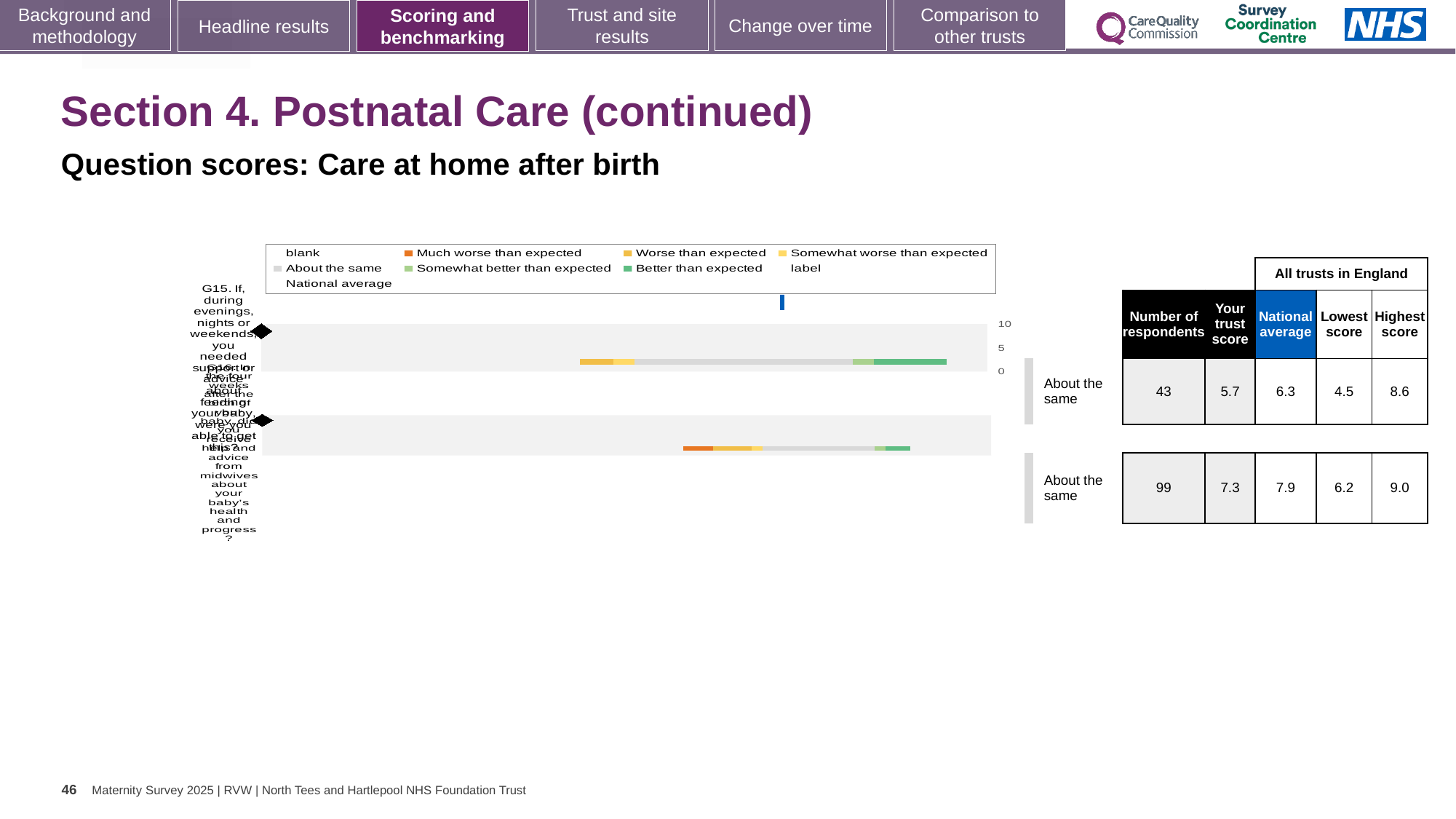
What is the number of respondents for the top question row? 43 What kind of chart is shown on the slide? bar chart What is the trust score for the top question row? 5.7 Which question row has the higher number of respondents? The bottom row (99) For the top question row, which is larger: the trust score or the national average? National average What benchmark category is shown for both question rows? About the same What is the highest score among all trusts in England for the top question row? 8.6 How many entries does the chart legend list? 9 What is the national average for the bottom question row? 7.9 What is the difference between the national average and the trust score for the bottom question row? 0.6 How many question rows are plotted in the chart? 2 What is the lowest score among all trusts in England for the bottom question row? 6.2